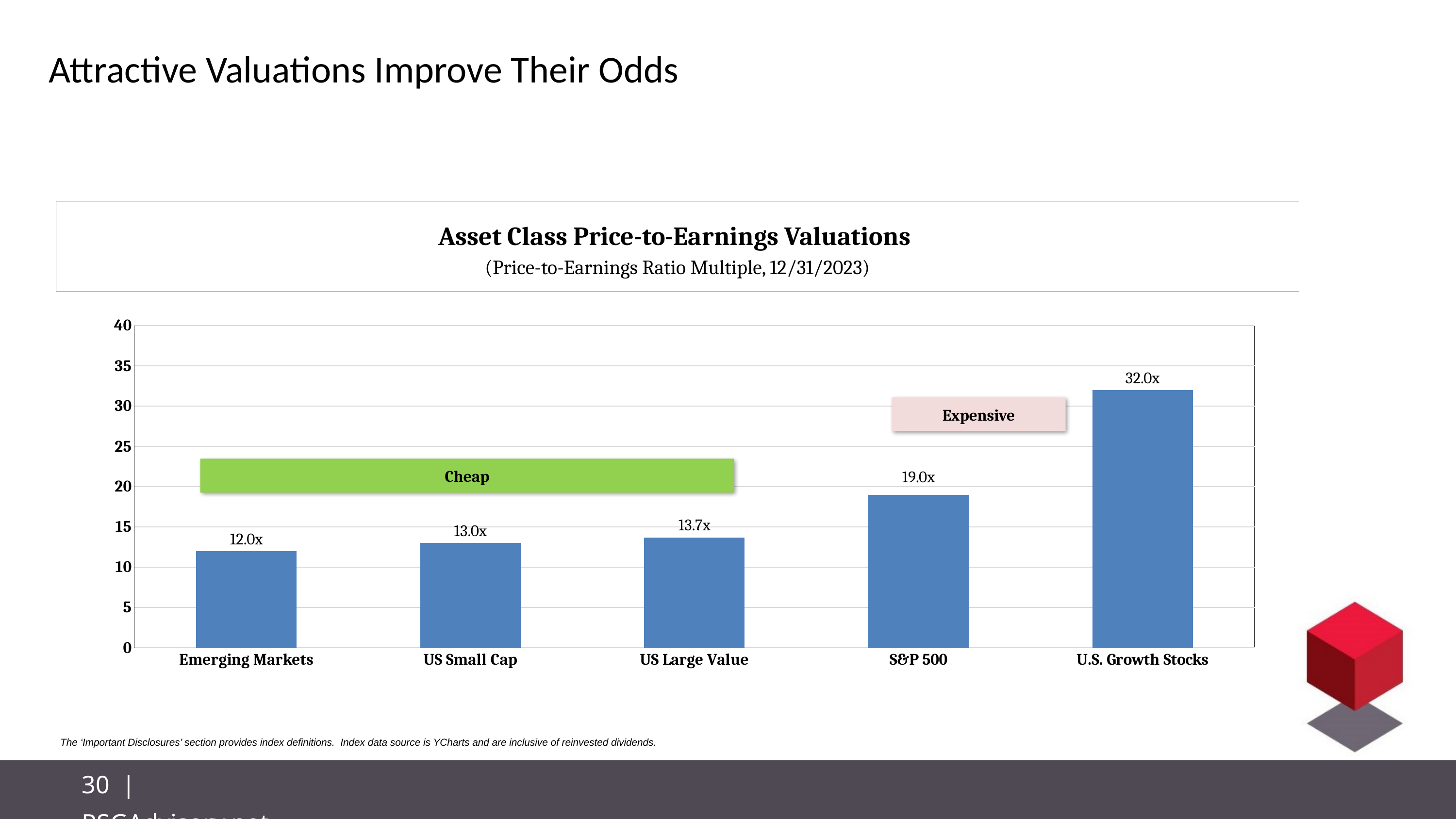
What is the difference between the price-to-earnings multiples of U.S. Growth Stocks and the S&P 500? 13.0x What is the price-to-earnings ratio multiple for Emerging Markets? 12.0x Which asset class has the highest price-to-earnings ratio multiple? U.S. Growth Stocks How many asset classes are shown in the chart? 5 Which has a higher price-to-earnings multiple, US Small Cap or the S&P 500? S&P 500 Which asset class has the lowest price-to-earnings ratio multiple? Emerging Markets What is the title of the chart? Asset Class Price-to-Earnings Valuations What is the price-to-earnings ratio multiple for the S&P 500? 19.0x Do the price-to-earnings multiples rise or fall from left to right across the asset classes? Rise What kind of chart is shown on the slide? Bar chart What is the price-to-earnings ratio multiple for US Large Value? 13.7x Is the value for U.S. Growth Stocks greater or less than 30? greater